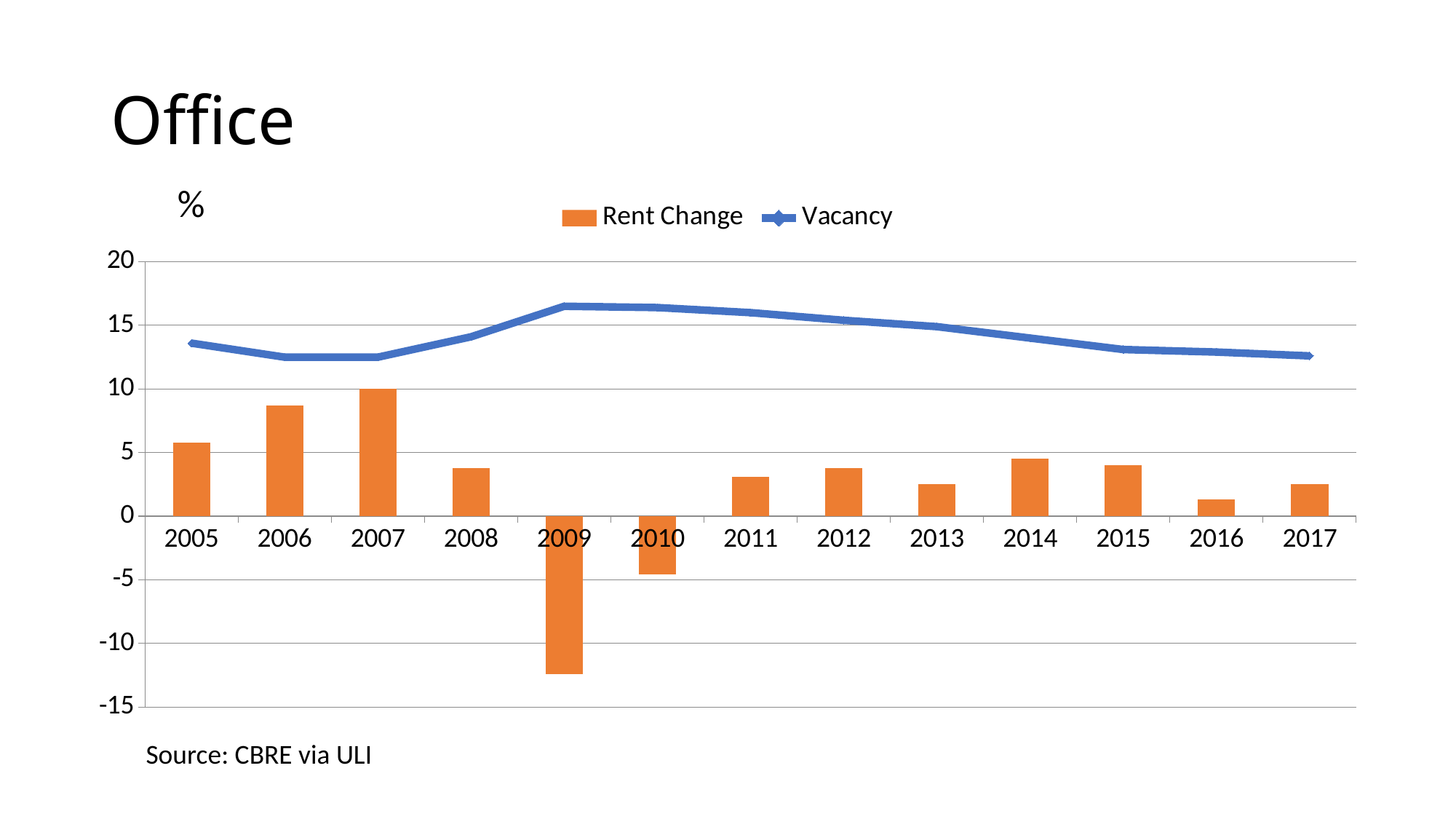
Which series is shown as a blue line? Vacancy How many series does the legend list? 2 Which year has the highest Rent Change? 2007 How many years are shown on the x axis? 13 What kind of chart is shown on the slide? combined bar and line chart Is the Rent Change for 2009 greater or less than -10? less Which is larger, the Rent Change for 2014 or for 2016? 2014 Is the Rent Change for 2006 greater or less than 5? greater Which year has the lowest Rent Change? 2009 Does the Vacancy line rise or fall from 2009 to 2017? fall Which year has the highest Vacancy? 2009 Is the Vacancy for 2010 greater or less than 15? greater